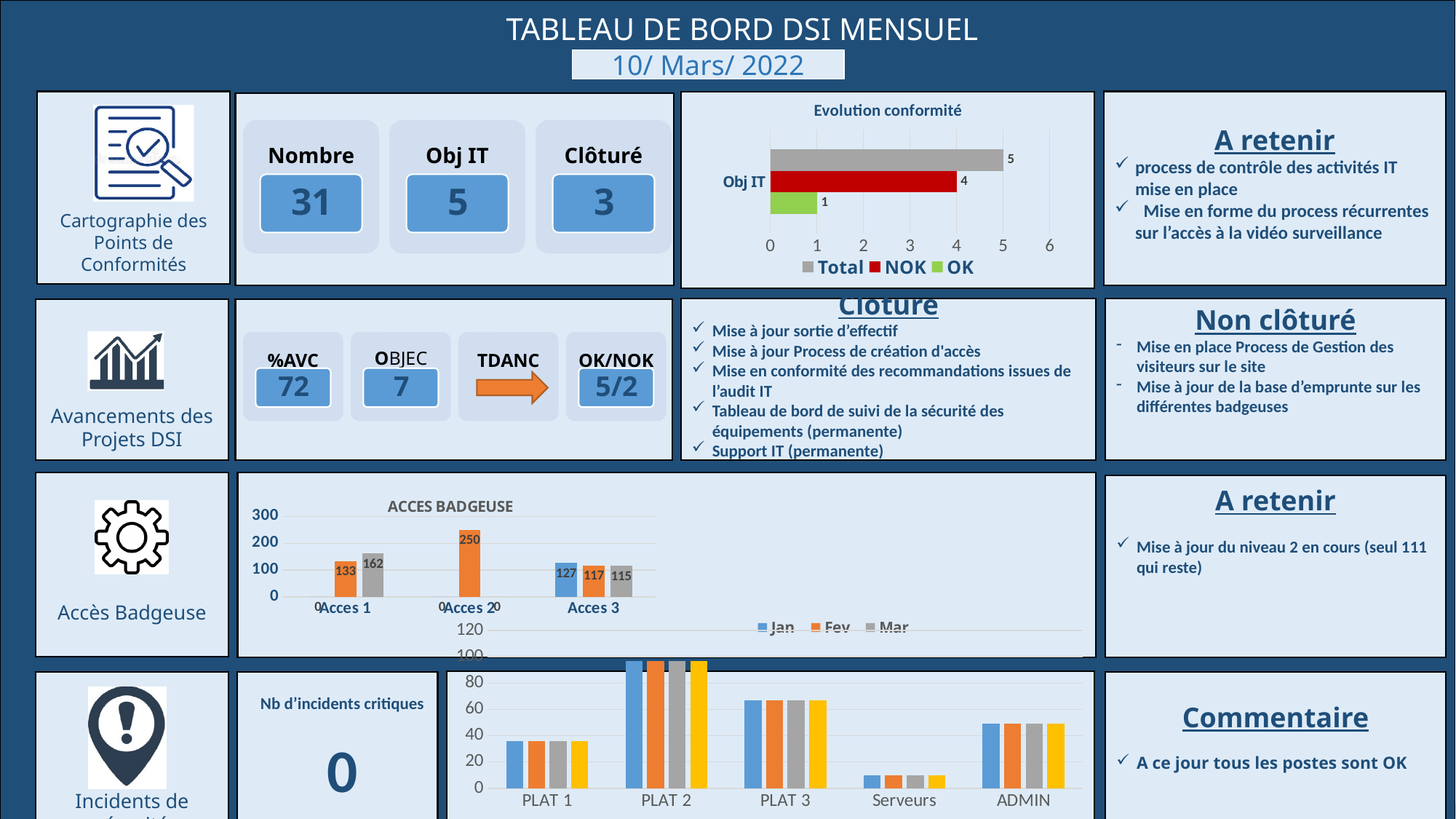
In the bottom chart (PLAT 1 to ADMIN), which category has the lowest values? Serveurs In the bottom chart (PLAT 1 to ADMIN), are the values for PLAT 2 greater or less than 80? greater In the 'Evolution conformité' chart, what is the difference between the NOK and OK values for Obj IT? 3 In the 'ACCES BADGEUSE' chart, is the Fev value for Acces 1 larger or the Mar value for Acces 1? Mar In the 'Evolution conformité' chart, what is the value of the Total series for Obj IT? 5 How many series does the legend of the 'Evolution conformité' chart list? 3 In the 'ACCES BADGEUSE' chart, what is the difference between the Jan and Mar values for Acces 3? 12 In the 'ACCES BADGEUSE' chart, what is the Fev value for Acces 2? 250 In the 'ACCES BADGEUSE' chart, which category has the highest Fev value? Acces 2 In the 'Evolution conformité' chart, what is the value of the NOK series for Obj IT? 4 In the 'ACCES BADGEUSE' chart, what is the Mar value for Acces 1? 162 How many categories are shown on the x axis of the bottom chart (PLAT 1 to ADMIN)? 5